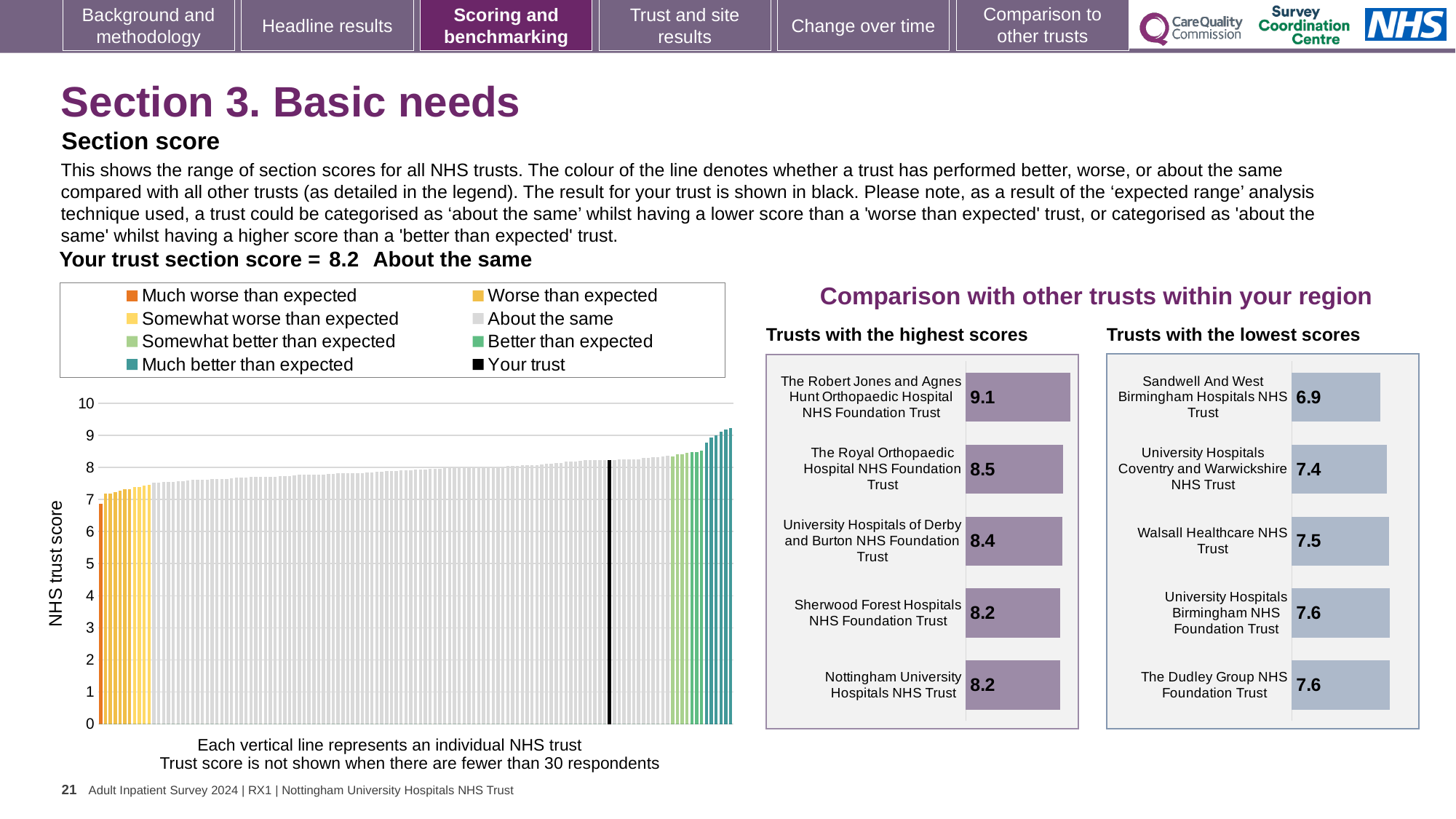
What type of chart is the large chart on the left showing NHS trust scores? Bar chart How many entries does the legend of the large chart on the left list? 8 In the 'Trusts with the highest scores' chart, what is the difference between the scores of The Robert Jones and Agnes Hunt Orthopaedic Hospital NHS Foundation Trust and The Royal Orthopaedic Hospital NHS Foundation Trust? 0.6 In the 'Trusts with the highest scores' chart, what is the score for University Hospitals of Derby and Burton NHS Foundation Trust? 8.4 In the 'Trusts with the lowest scores' chart, what is the difference between the scores of The Dudley Group NHS Foundation Trust and Sandwell And West Birmingham Hospitals NHS Trust? 0.7 In the 'Trusts with the highest scores' chart, what is the score for The Robert Jones and Agnes Hunt Orthopaedic Hospital NHS Foundation Trust? 9.1 How many trusts are listed in the 'Trusts with the highest scores' chart? 5 In the 'Trusts with the lowest scores' chart, which is larger: the score for University Hospitals Coventry and Warwickshire NHS Trust or the score for Sandwell And West Birmingham Hospitals NHS Trust? University Hospitals Coventry and Warwickshire NHS Trust In the 'Trusts with the lowest scores' chart, what is the score for Walsall Healthcare NHS Trust? 7.5 In the 'Trusts with the lowest scores' chart, which trust has the lowest score? Sandwell And West Birmingham Hospitals NHS Trust In the large chart on the left, do the NHS trust scores rise or fall from left to right? Rise In the large chart on the left, what is the section score for your trust (the black bar)? 8.2